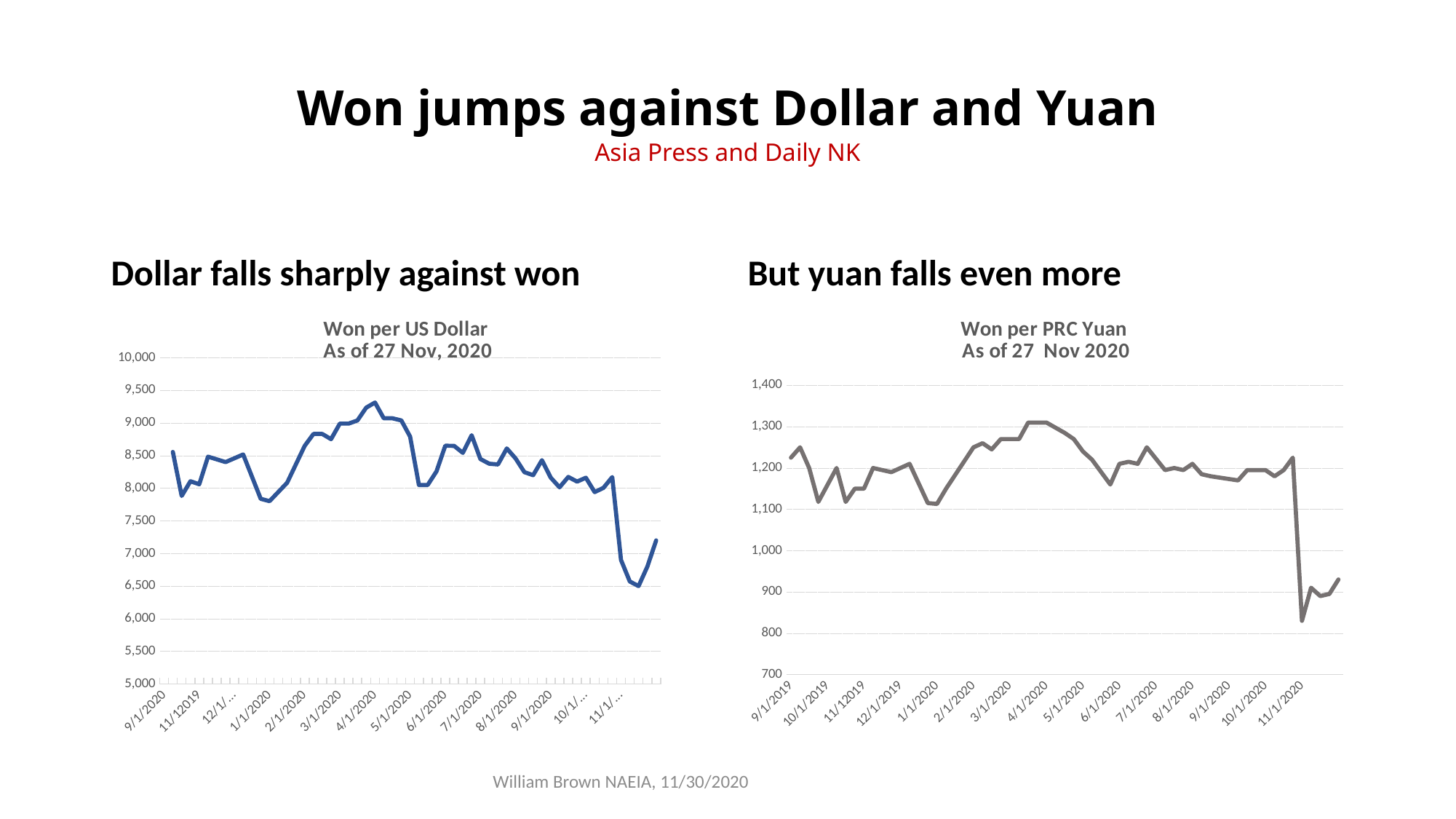
What kind of chart is the 'Won per PRC Yuan' chart on the right? line chart In the 'Won per US Dollar' chart, is the lowest value after 11/1/2020 greater or less than 7,000? less In the 'Won per PRC Yuan' chart, is the peak value around 4/1/2020 greater or less than 1,200? greater What is the title of the chart on the right? Won per PRC Yuan As of 27 Nov 2020 In the 'Won per US Dollar' chart, is the peak value around 4/1/2020 greater or less than 9,000? greater What kind of chart is the 'Won per US Dollar' chart on the left? line chart In the 'Won per PRC Yuan' chart, does the value rise or fall sharply right after 11/1/2020? fall What colour is the line in the 'Won per US Dollar' chart? blue In the 'Won per US Dollar' chart, does the line end higher or lower than where it starts? lower